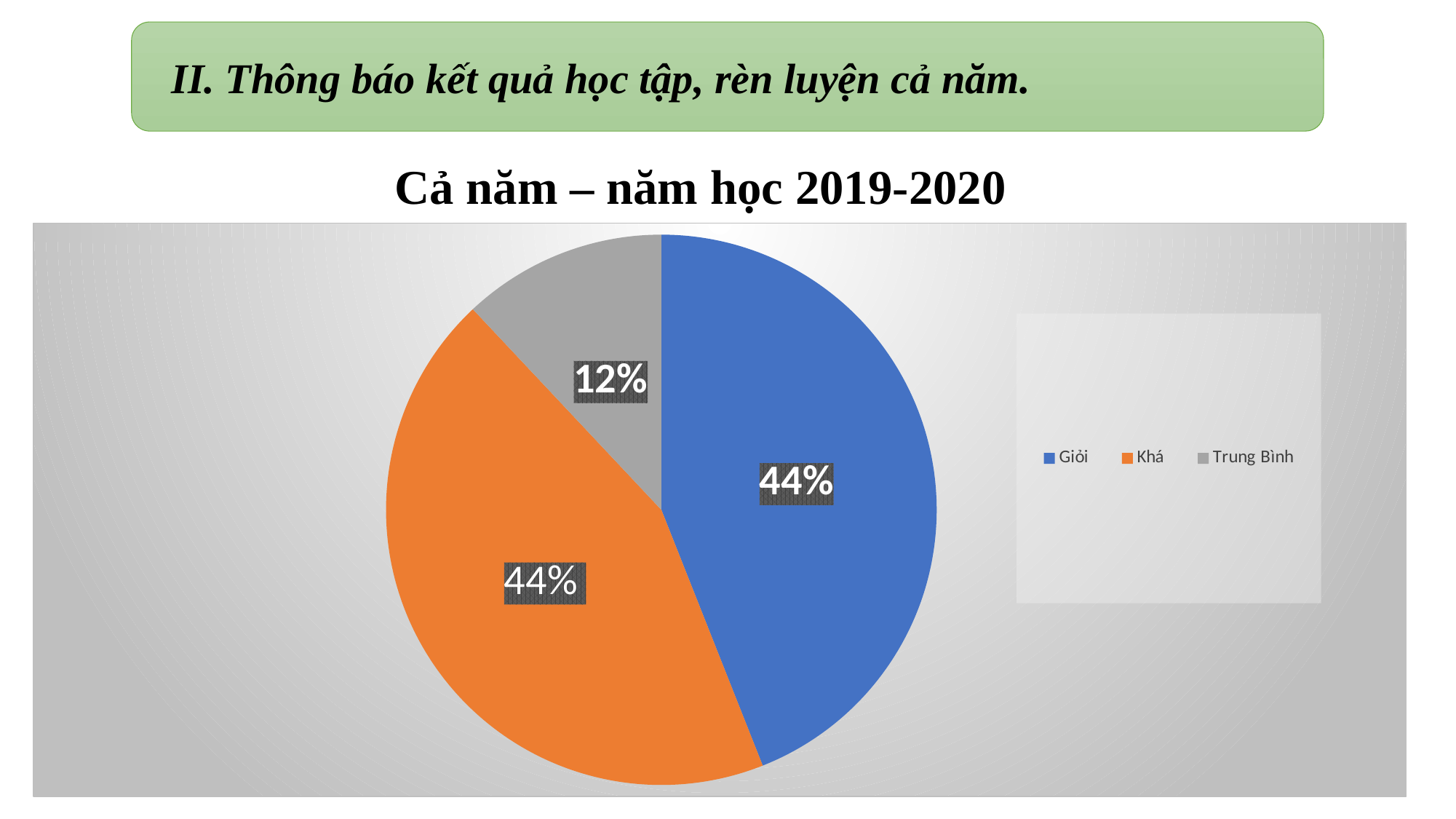
What share of the pie does Giỏi represent? 44% What share of the pie does Khá represent? 44% How many categories are shown in the pie chart? 3 What is the difference between the share for Giỏi and the share for Trung Bình? 32% Which is larger, the slice for Giỏi or the slice for Trung Bình? Giỏi What is the title of the chart? Cả năm – năm học 2019-2020 What is the difference between the share for Khá and the share for Giỏi? 0% Which colour represents Khá in the pie chart? orange What kind of chart is shown on the slide? pie chart What share of the pie does Trung Bình represent? 12% Which is larger, the slice for Khá or the slice for Trung Bình? Khá Which category has the smallest slice of the pie? Trung Bình